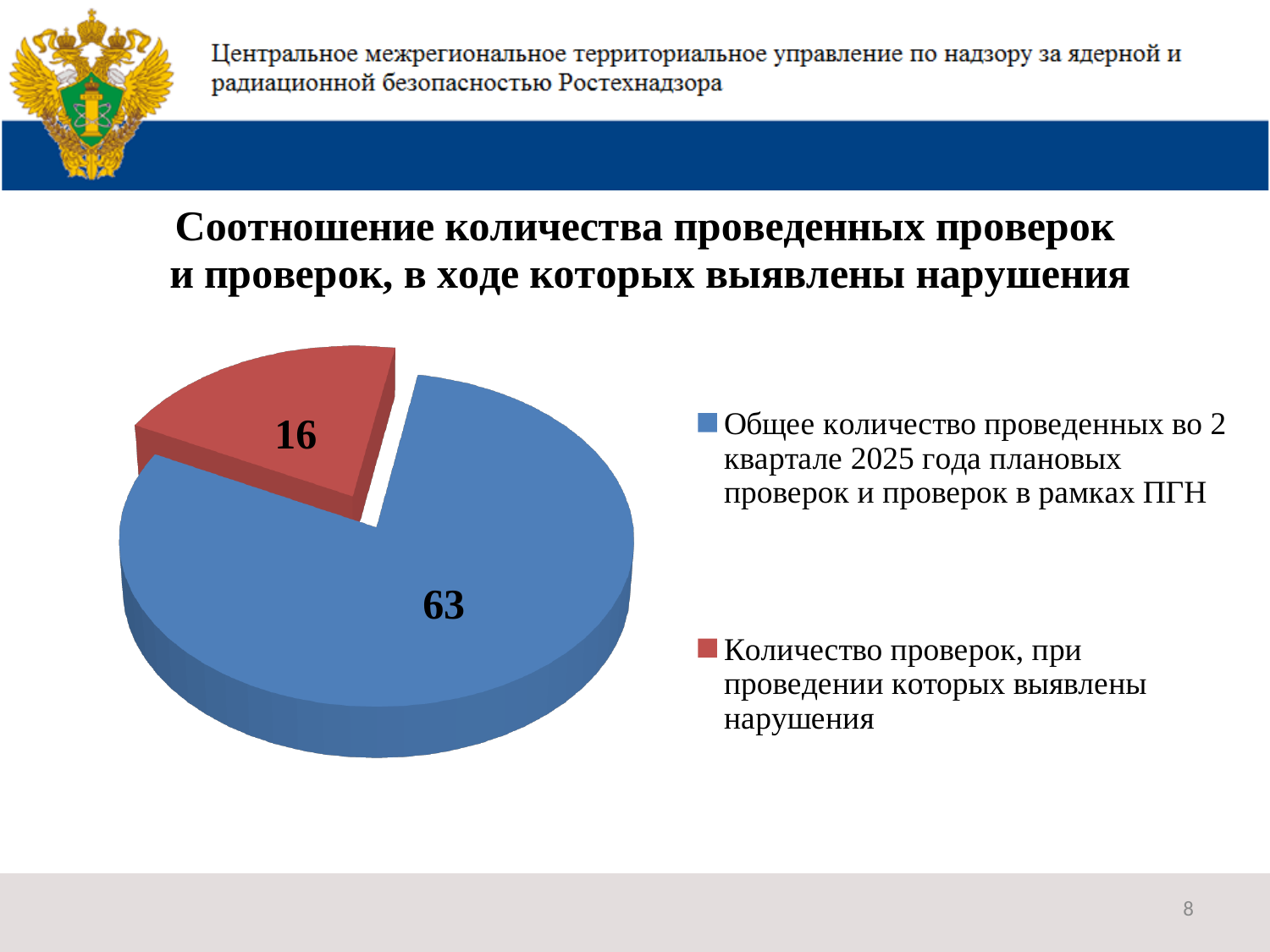
What colour is the slice representing the number of inspections with violations identified? Red What is the value for the number of inspections in which violations were identified (Количество проверок, при проведении которых выявлены нарушения)? 16 What is the difference between the total number of inspections conducted (63) and the number of inspections with violations identified (16)? 47 Which slice of the pie chart is the largest? Общее количество проведенных во 2 квартале 2025 года плановых проверок и проверок в рамках ПГН What is the sum of the two values shown on the pie chart? 79 Which is larger: the total number of inspections conducted or the number of inspections with violations identified? The total number of inspections conducted Which slice of the pie chart is the smallest? Количество проверок, при проведении которых выявлены нарушения How many entries does the legend list? 2 What colour is the slice representing the total number of inspections conducted in Q2 2025? Blue How many slices does the pie chart have? 2 What is the value for the total number of planned inspections and inspections within the framework of PGN conducted in Q2 2025 (Общее количество проведенных во 2 квартале 2025 года плановых проверок и проверок в рамках ПГН)? 63 What kind of chart is shown on the slide? Pie chart